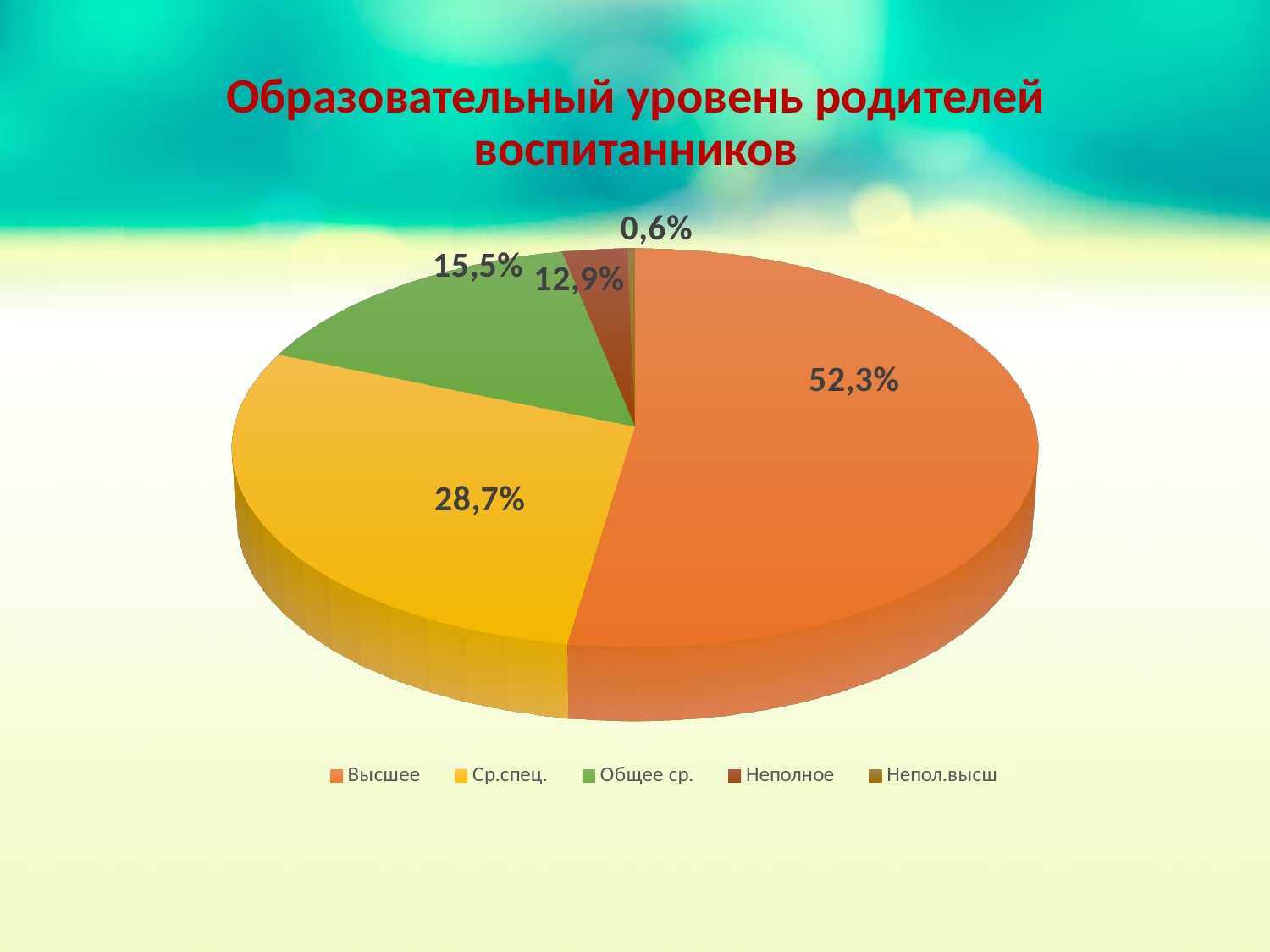
Which category has the smallest slice of the pie? Непол.высш What is the value shown for Общее ср.? 15,5% What colour is the Высшее slice? Orange What kind of chart is shown on the slide? Pie chart Which category has the largest slice of the pie? Высшее What is the value shown for Ср.спец.? 28,7% By how many percentage points does Высшее exceed Ср.спец.? 23,6% Which is larger, the slice for Ср.спец. or the slice for Общее ср.? Ср.спец. How many categories does the legend list? 5 What is the title of the chart? Образовательный уровень родителей воспитанников What share of the pie does the Высшее slice have? 52,3% What is the value shown for Непол.высш? 0,6%